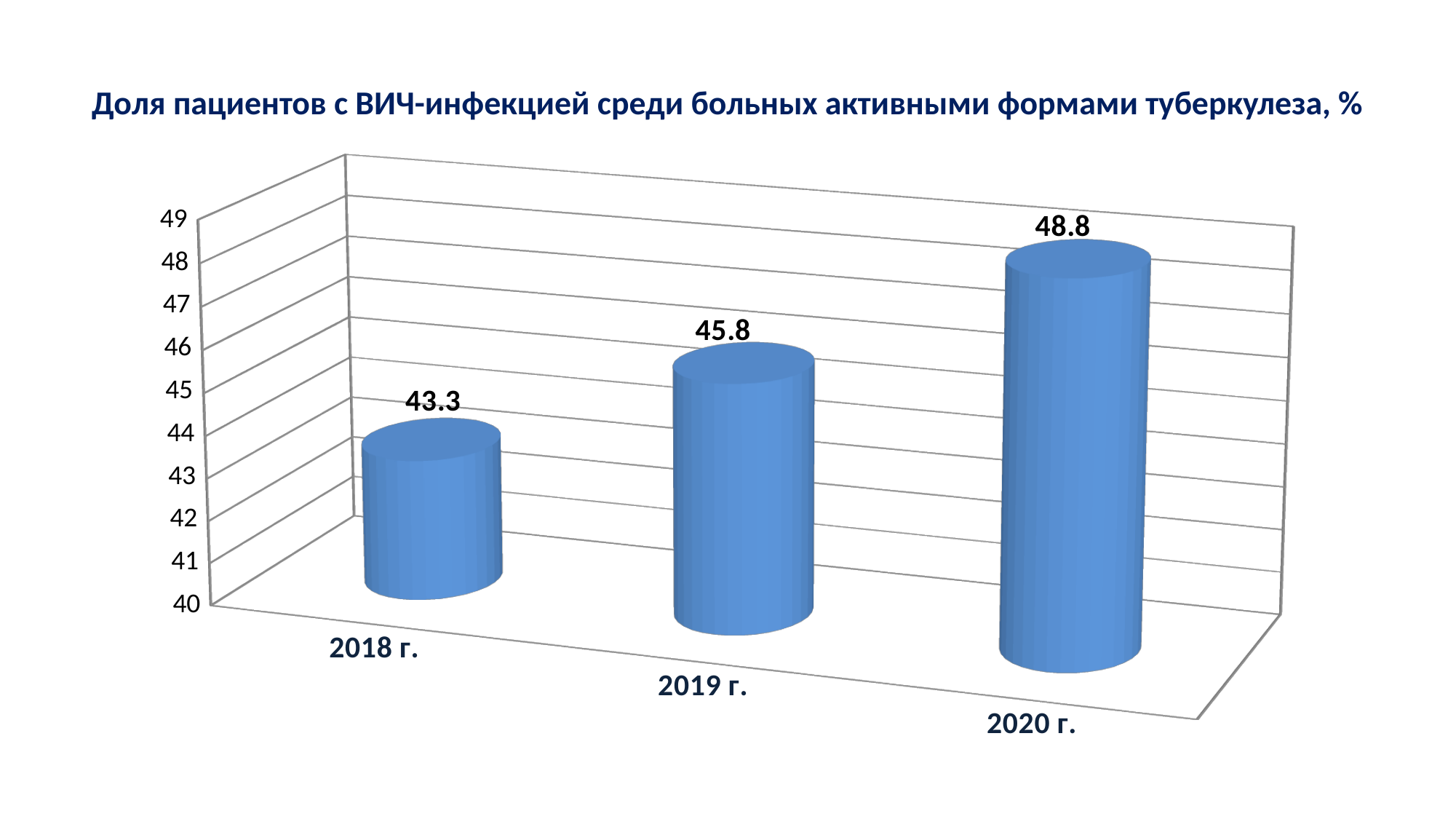
Which is larger, the value for 2019 г. or the value for 2020 г.? 2020 г. Is the value for 2019 г. greater or less than 45? greater How many years are shown on the chart? 3 What is the difference between the values for 2020 г. and 2018 г.? 5.5 What kind of chart is shown on the slide? bar chart What is the value for 2020 г.? 48.8 Do the values rise or fall from 2018 г. to 2020 г.? rise What is the value for 2018 г.? 43.3 What is the value for 2019 г.? 45.8 Which year has the lowest value? 2018 г. Which year has the highest value? 2020 г. What is the difference between the values for 2019 г. and 2018 г.? 2.5